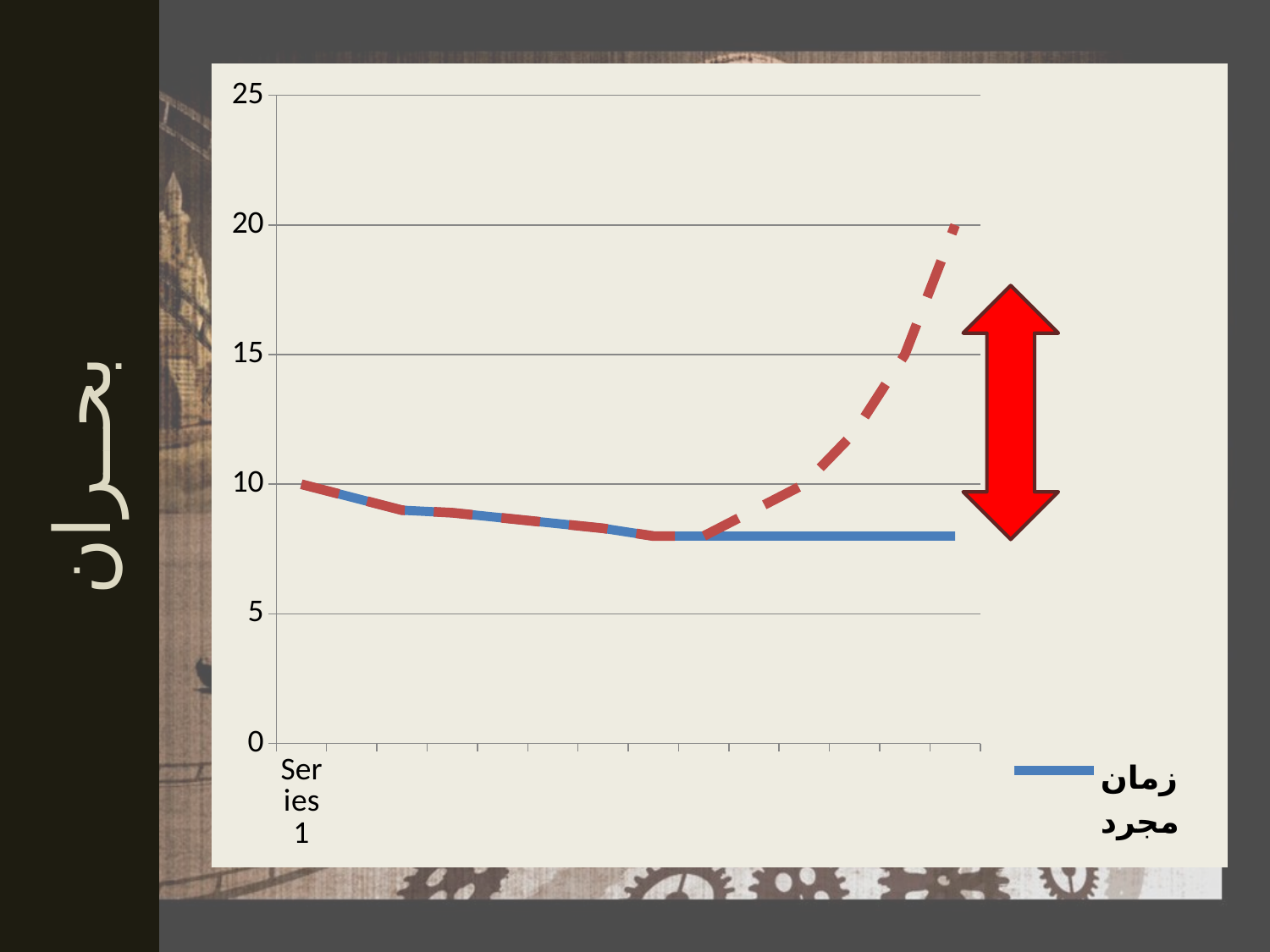
What is the category label shown on the x axis? Series 1 Does the red dashed line rise or fall over the right half of the chart? rise What kind of chart is shown on the slide? line chart What is the highest value shown on the y axis? 25 Is the final value of the red dashed line greater or less than 15? greater What is the value of the first point of the solid blue line? 10 What is the name of the series shown in the legend? زمان مجرد Is the lowest value of the solid blue line greater or less than 5? greater Is the final value of the solid blue line greater or less than 10? less How many series does the legend list? 1 Does the solid blue line rise or fall from its first point to its last point? fall At the right end of the chart, which line is higher, the red dashed line or the solid blue line? the red dashed line